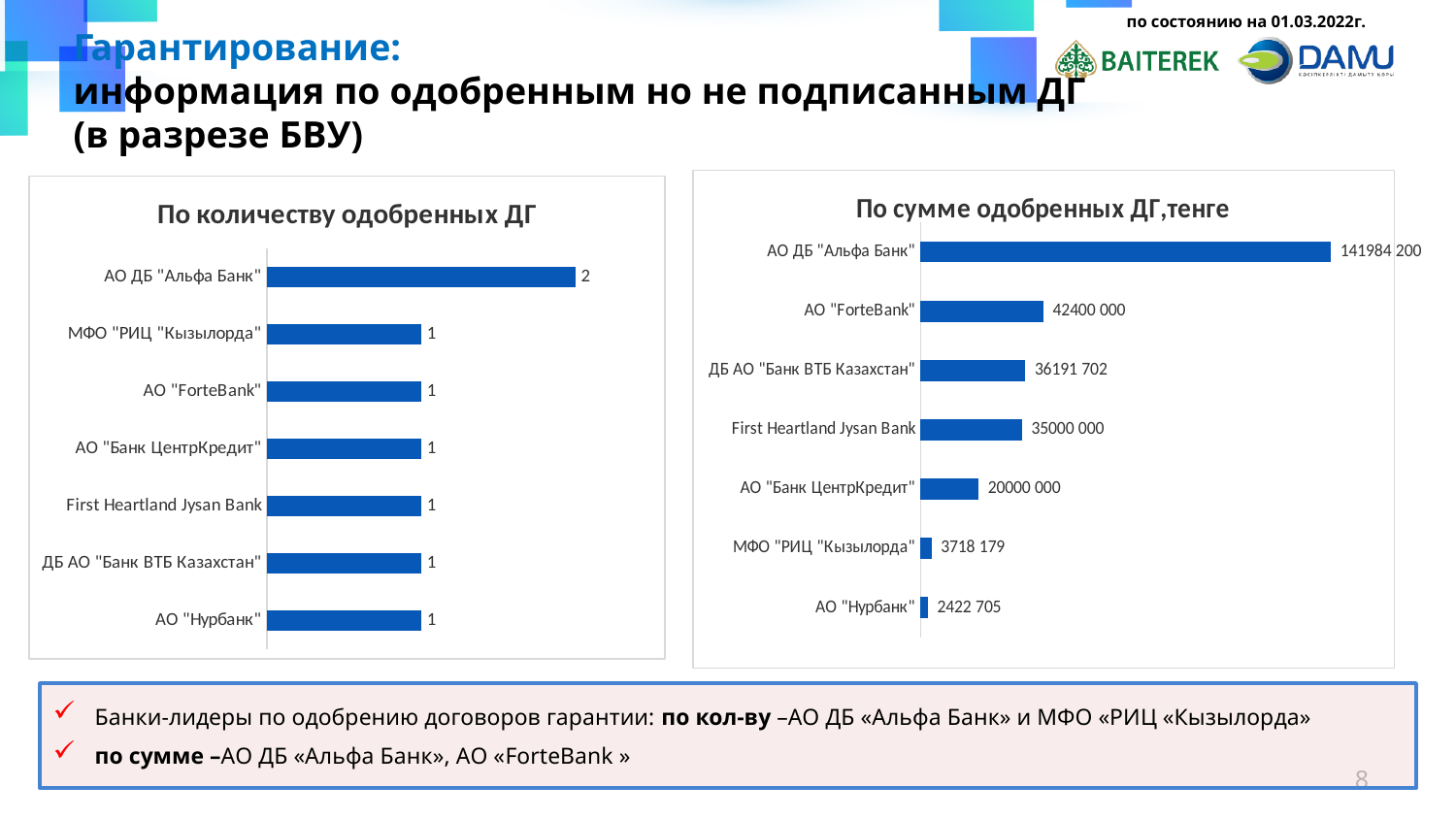
In the chart "По количеству одобренных ДГ", what is the difference between АО ДБ "Альфа Банк" and АО "Нурбанк"? 1 What type of chart is "По сумме одобренных ДГ,тенге"? Bar chart In the chart "По количеству одобренных ДГ", how many categories are shown? 7 In the chart "По сумме одобренных ДГ,тенге", what is the difference between First Heartland Jysan Bank and АО "Банк ЦентрКредит"? 15000 000 In the chart "По сумме одобренных ДГ,тенге", what is the value for АО "ForteBank"? 42400 000 What is the title of the chart on the left side of the slide? По количеству одобренных ДГ In the chart "По сумме одобренных ДГ,тенге", what is the value for ДБ АО "Банк ВТБ Казахстан"? 36191 702 In the chart "По сумме одобренных ДГ,тенге", which bank has the highest value? АО ДБ "Альфа Банк" In the chart "По сумме одобренных ДГ,тенге", which is larger: First Heartland Jysan Bank or АО "Банк ЦентрКредит"? First Heartland Jysan Bank In the chart "По сумме одобренных ДГ,тенге", which bank has the lowest value? АО "Нурбанк" In the chart "По количеству одобренных ДГ", what is the value for АО ДБ "Альфа Банк"? 2 In the chart "По количеству одобренных ДГ", which bank has the highest value? АО ДБ "Альфа Банк"